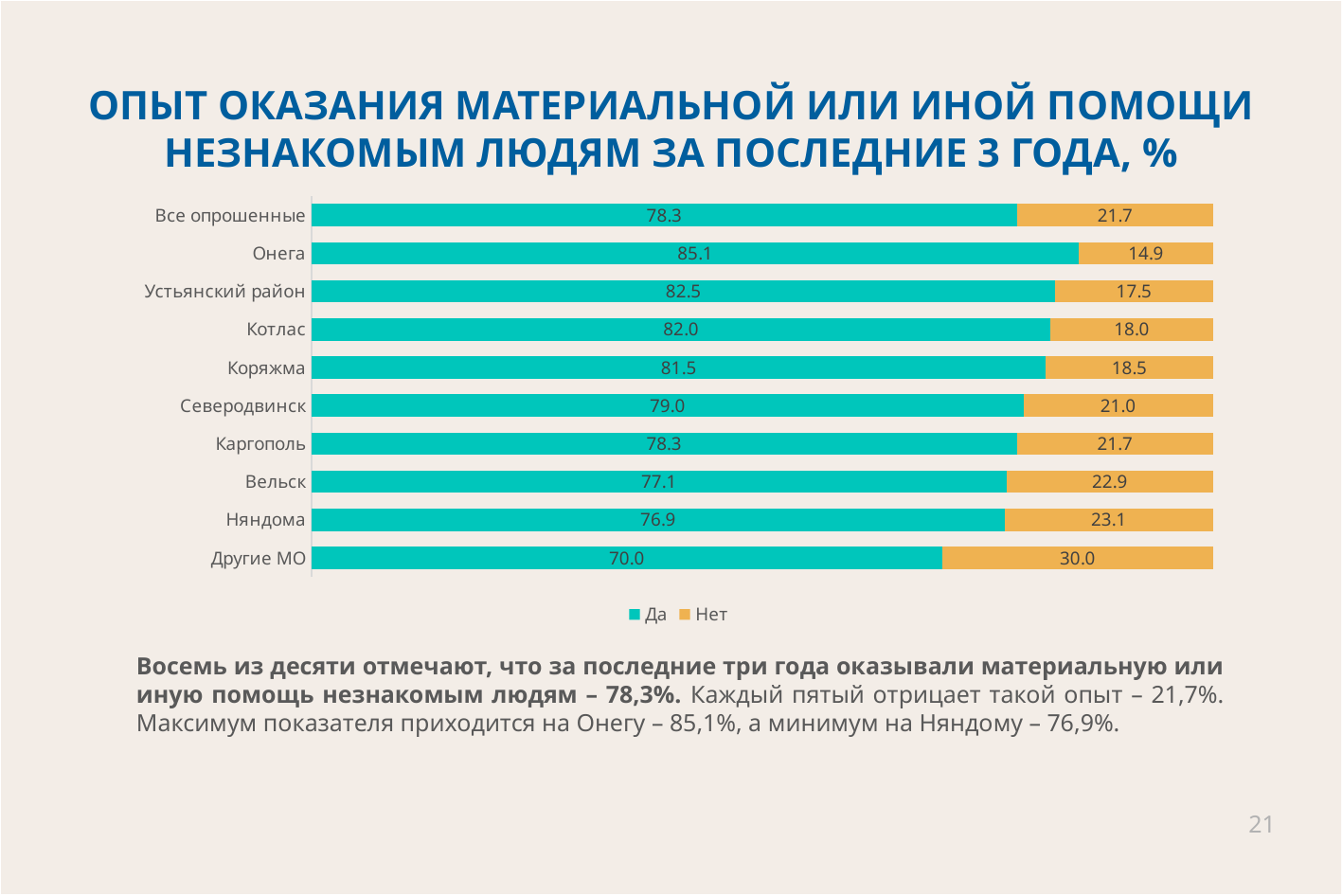
Какое значение «Да» показано для категории «Все опрошенные»? 78.3 На сколько значение «Да» для Онеги больше, чем для Няндомы? 8.2 Какого типа эта диаграмма? Столбчатая (линейчатая) диаграмма с накоплением Сколько категорий показано на диаграмме? 10 Чему равна сумма значений «Да» и «Нет» для Северодвинска? 100.0 У какой категории самое высокое значение «Нет»? Другие МО У какой категории самое низкое значение «Да»? Другие МО Сколько рядов данных перечислено в легенде? 2 У какой категории самое высокое значение «Да»? Онега Какое значение «Нет» показано для Няндомы? 23.1 Что больше: значение «Да» для Котласа или для Коряжмы? Котлас Какое значение «Да» показано для Онеги? 85.1